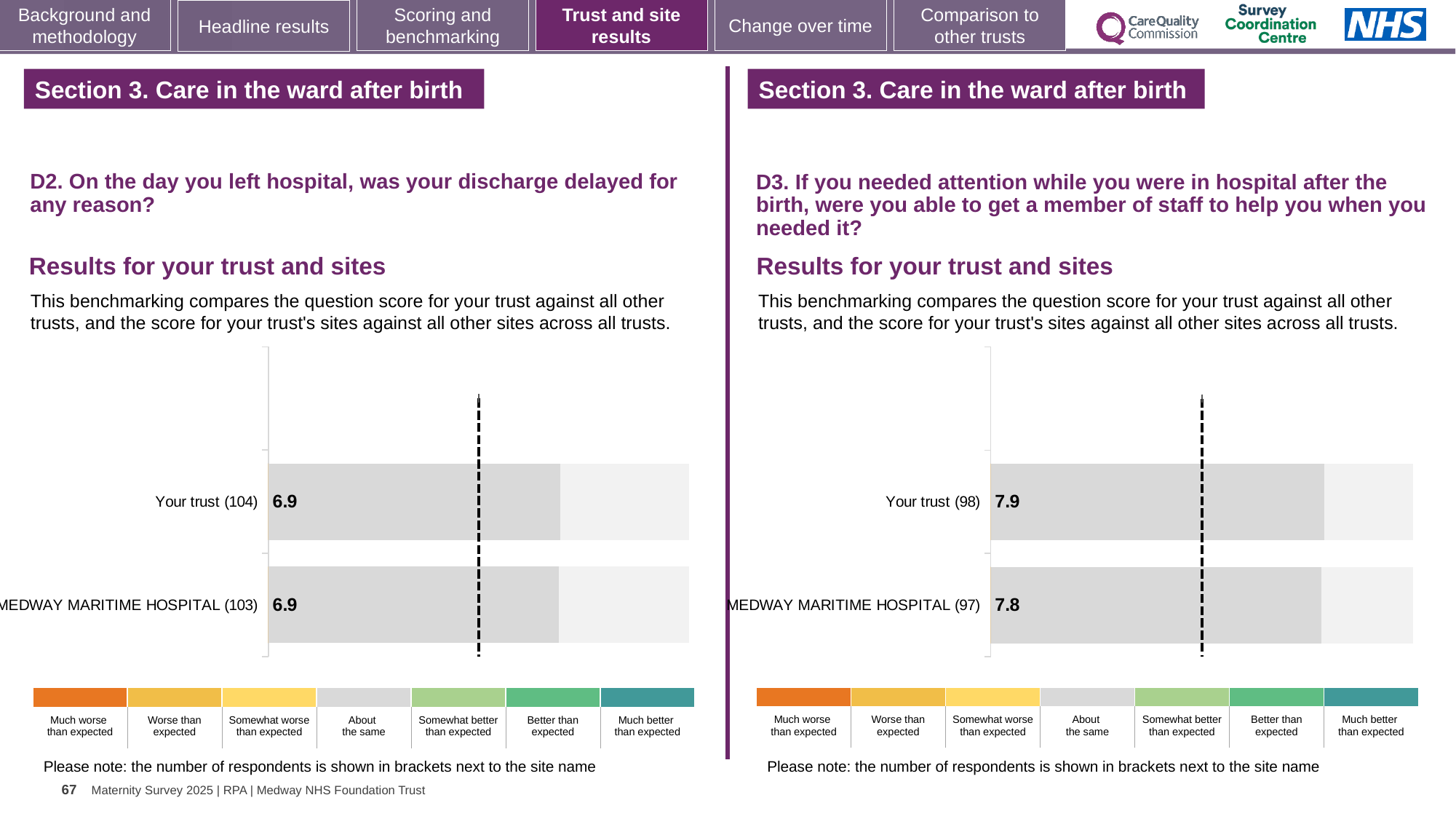
On the left chart (D2), what is the score for Medway Maritime Hospital? 6.9 On the left chart (D2), what is the difference between the score for Your trust and the score for Medway Maritime Hospital? 0 On the left chart (D2), how many respondents are shown in brackets for Your trust? 104 On the right chart (D3), how many respondents are shown in brackets for Medway Maritime Hospital? 97 What type of chart is used on the left (D2)? Bar chart On the left chart (D2), what is the score for Your trust? 6.9 How many bars are plotted on the right chart (D3)? 2 On the right chart (D3), what is the difference between the score for Your trust and the score for Medway Maritime Hospital? 0.1 On the right chart (D3), what is the score for Your trust? 7.9 How many bars are plotted on the left chart (D2)? 2 On the right chart (D3), which has the higher score, Your trust or Medway Maritime Hospital? Your trust On the right chart (D3), what is the score for Medway Maritime Hospital? 7.8